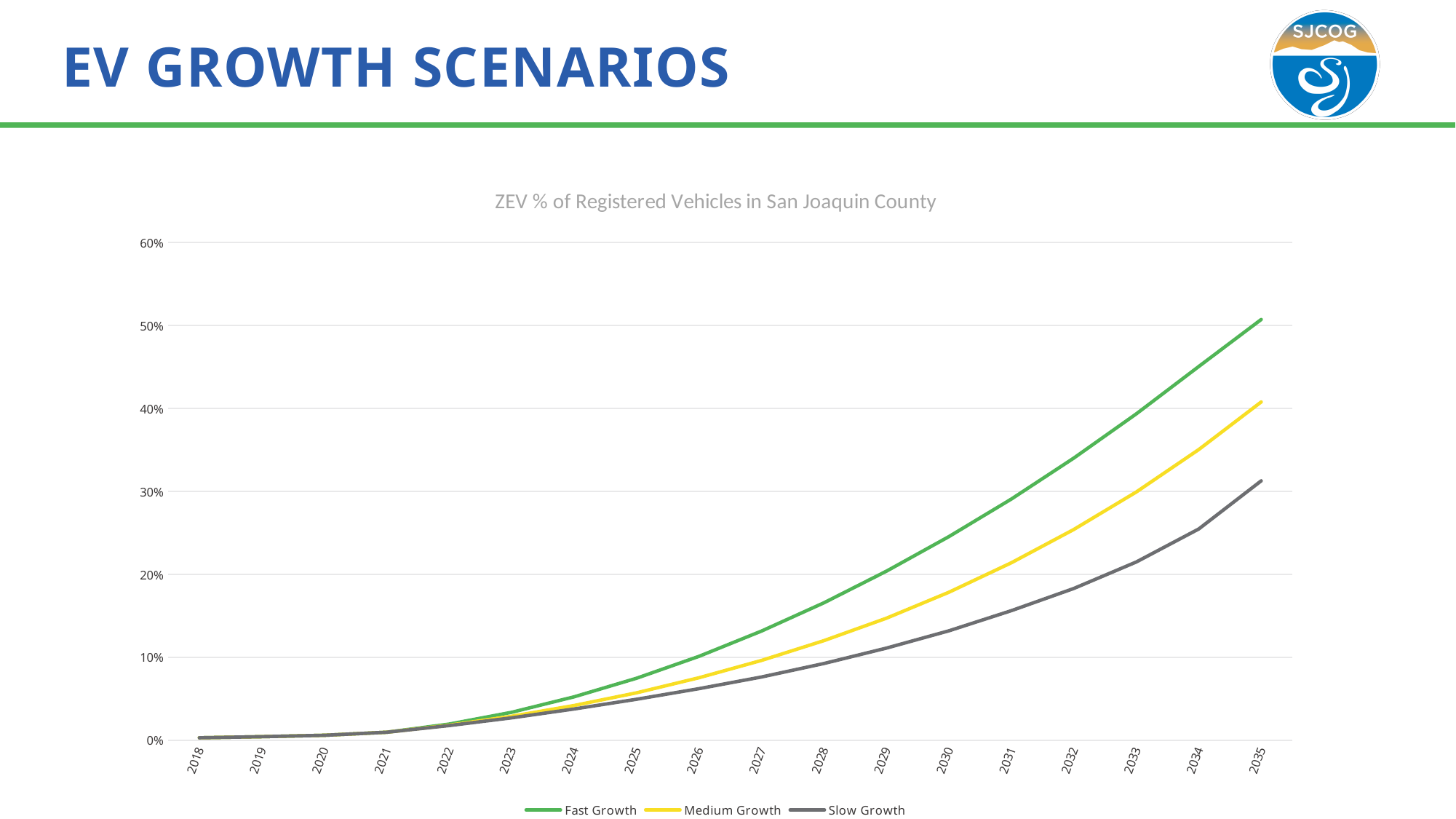
Which series has the highest value in 2035? Fast Growth What is the title of the chart? ZEV % of Registered Vehicles in San Joaquin County Do the values of the Medium Growth series rise or fall from 2018 to 2035? Rise Which series has the lowest value in 2035? Slow Growth What kind of chart is shown on the slide? Line chart How many series does the legend list? 3 How many years are shown along the x axis? 18 Is the Fast Growth value for 2030 greater or less than 20%? greater Is the Fast Growth value for 2035 greater or less than 40%? greater In 2035, which is larger: the Fast Growth value or the Slow Growth value? Fast Growth Is the Slow Growth value for 2034 greater or less than 30%? less Which colour is used for the Medium Growth series? Yellow